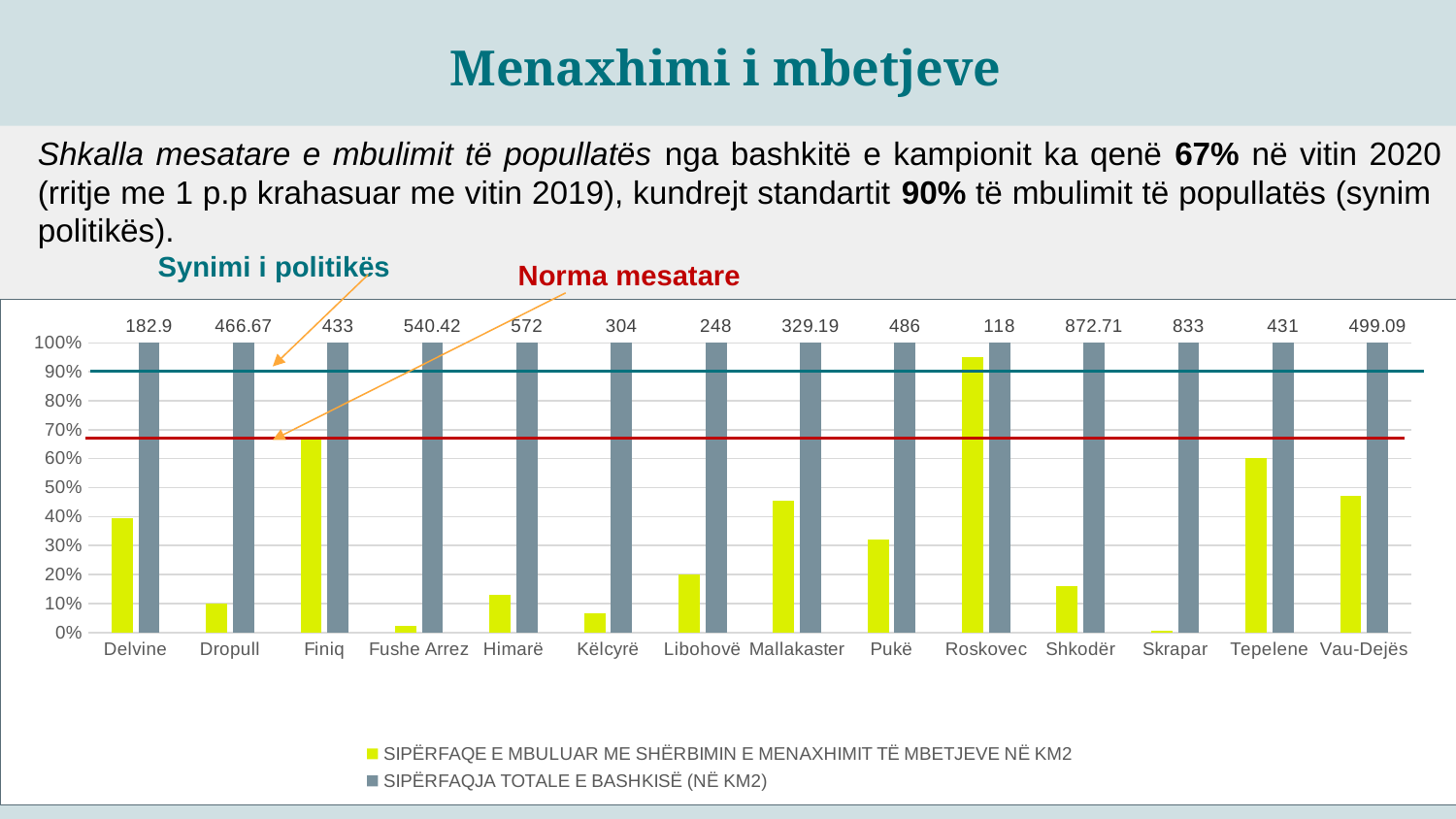
How many municipalities are shown on the x axis? 14 Which category has the lowest printed value above its bars? Roskovec What value is printed above the bars for Delvine? 182.9 What value is printed above the bars for Fushe Arrez? 540.42 What is the difference between the printed values for Shkodër and Skrapar? 39.71 Which has a larger printed value, Dropull or Finiq? Dropull What is the difference between the printed values for Himarë and Këlcyrë? 268 Which category has the highest printed value above its bars? Shkodër Is the yellow bar for Delvine greater or less than 50%? less How many series does the legend list? 2 Is the yellow bar for Roskovec greater or less than 90%? greater What value is printed above the bars for Shkodër? 872.71